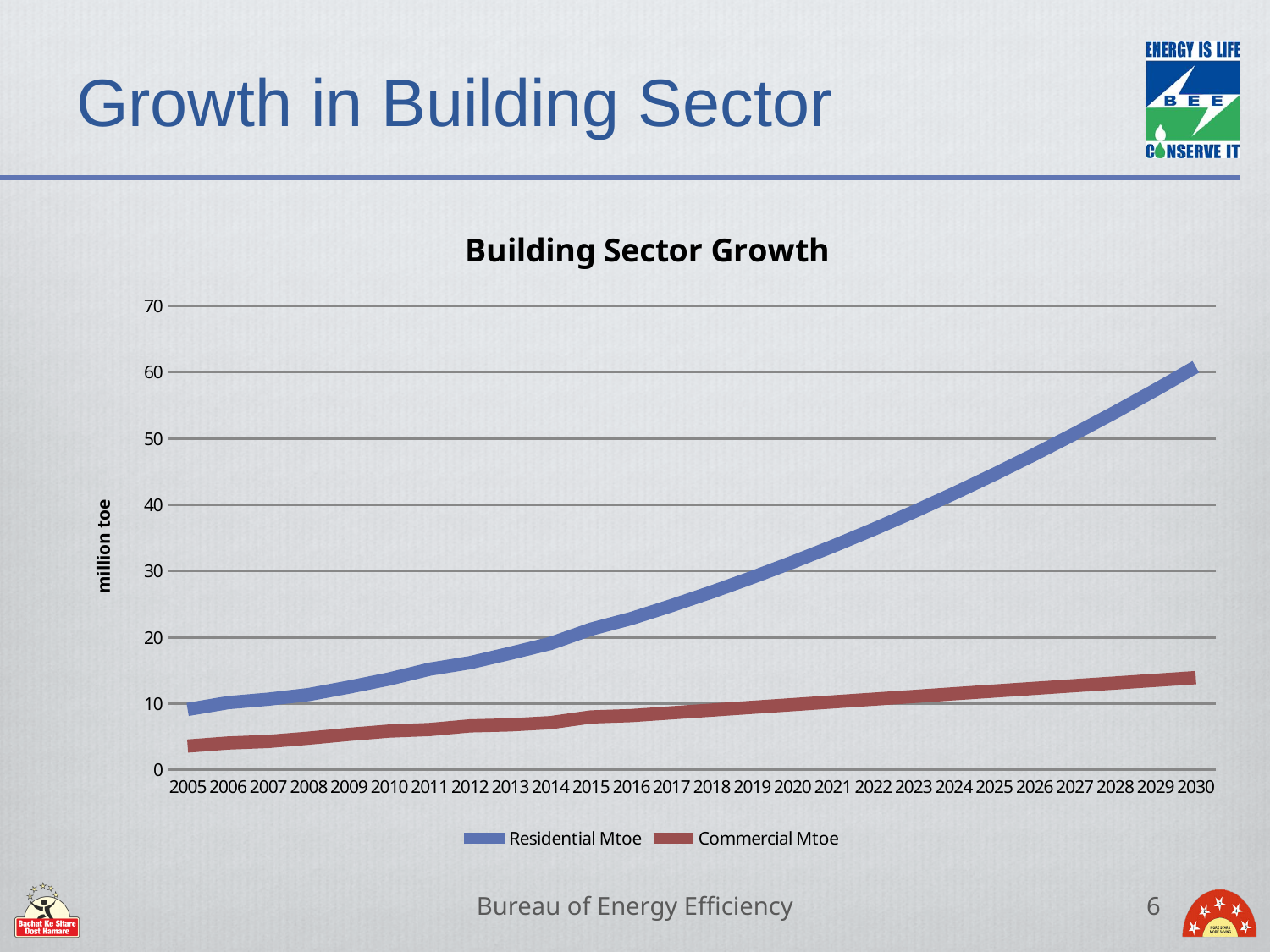
Is the value for Residential Mtoe in 2025 greater or less than 40? greater Is the value for Commercial Mtoe in 2030 greater or less than 10? greater What is the label on the vertical axis? million toe Is the value for Commercial Mtoe in 2005 greater or less than 10? less What is the title of the chart? Building Sector Growth Does the Residential Mtoe series rise or fall from 2005 to 2030? rise Which series is higher in 2030, Residential Mtoe or Commercial Mtoe? Residential Mtoe What kind of chart is shown on the slide? line chart Does the Commercial Mtoe series rise or fall from 2005 to 2030? rise How many series does the legend list? 2 How many years are plotted along the x axis? 26